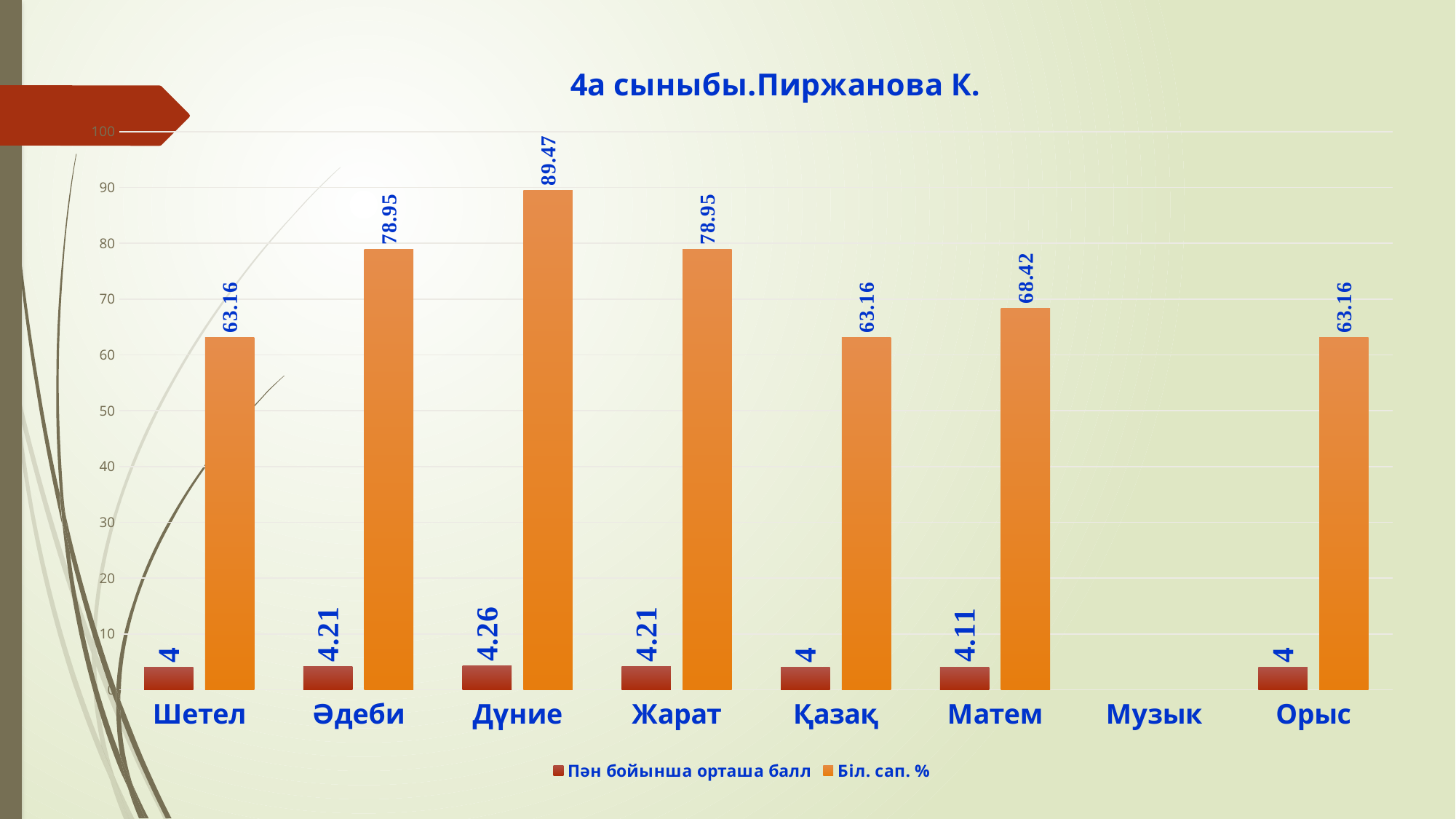
What is the difference between the Біл. сап. % values for Дүние and Матем? 21.05 Which is larger, the Біл. сап. % value for Әдеби or for Қазақ? Әдеби Which category has the highest Пән бойынша орташа балл value? Дүние Is the Біл. сап. % value for Матем greater or less than 60? greater How many categories are shown on the x axis? 8 What is the value of Біл. сап. % for Орыс? 63.16 What is the title of the chart? 4а сыныбы.Пиржанова К. How many series does the legend list? 2 Which category has the highest Біл. сап. % value? Дүние What is the value of Біл. сап. % for Дүние? 89.47 What is the value of Пән бойынша орташа балл for Матем? 4.11 What kind of chart is shown on the slide? bar chart